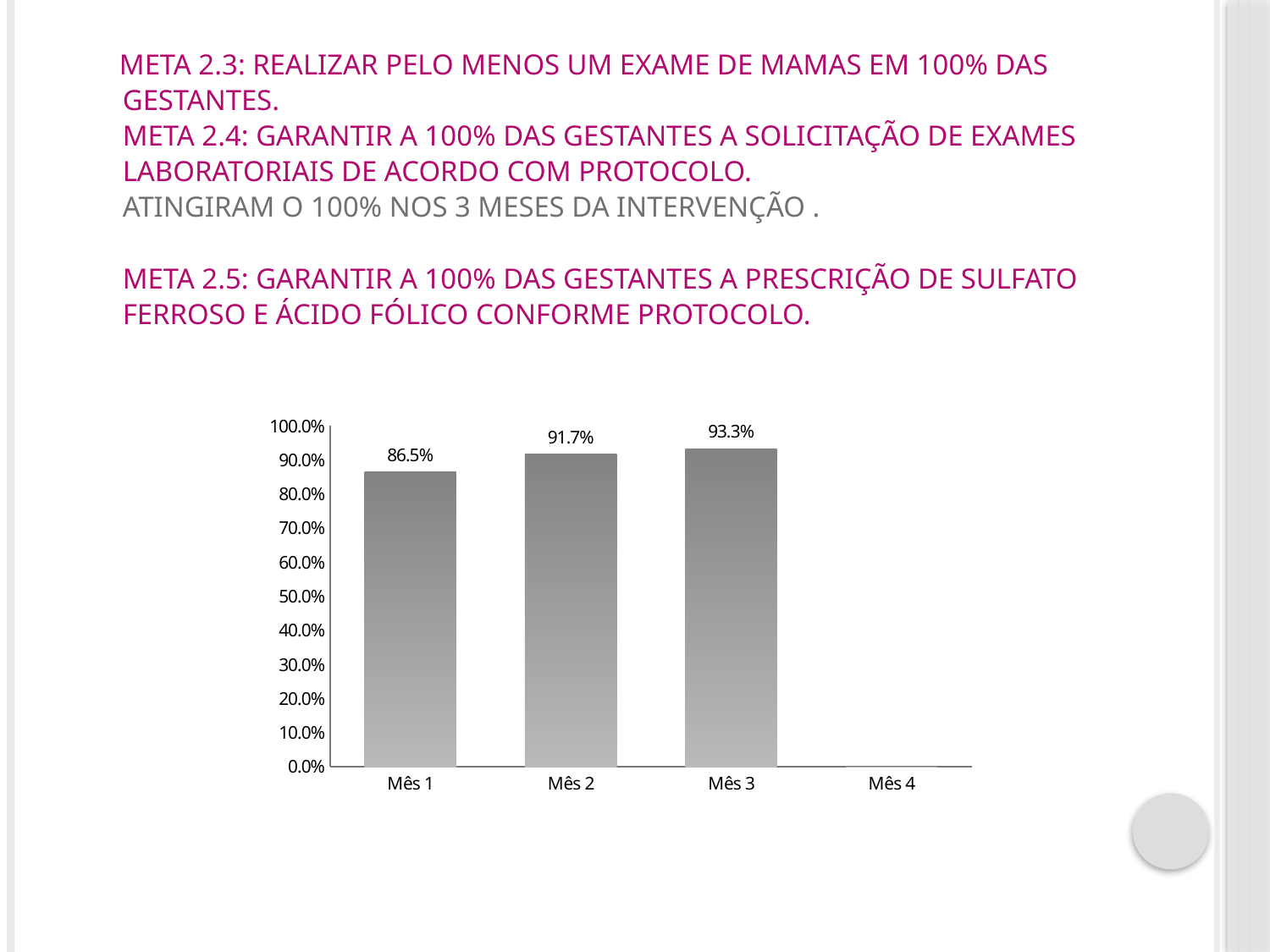
Which month has the lowest value among the bars with data labels? Mês 1 What is the value for Mês 1? 86.5% What is the value for Mês 2? 91.7% What is the difference between the values for Mês 3 and Mês 1? 6.8% Is the value for Mês 1 greater or less than 90.0%? less What kind of chart is shown on the slide? bar chart What is the difference between the values for Mês 2 and Mês 1? 5.2% What is the value for Mês 3? 93.3% Do the values rise or fall from Mês 1 to Mês 3? rise Which is larger, the value for Mês 2 or the value for Mês 3? Mês 3 How many categories are shown on the x axis? 4 Which month has the highest value among the bars shown? Mês 3